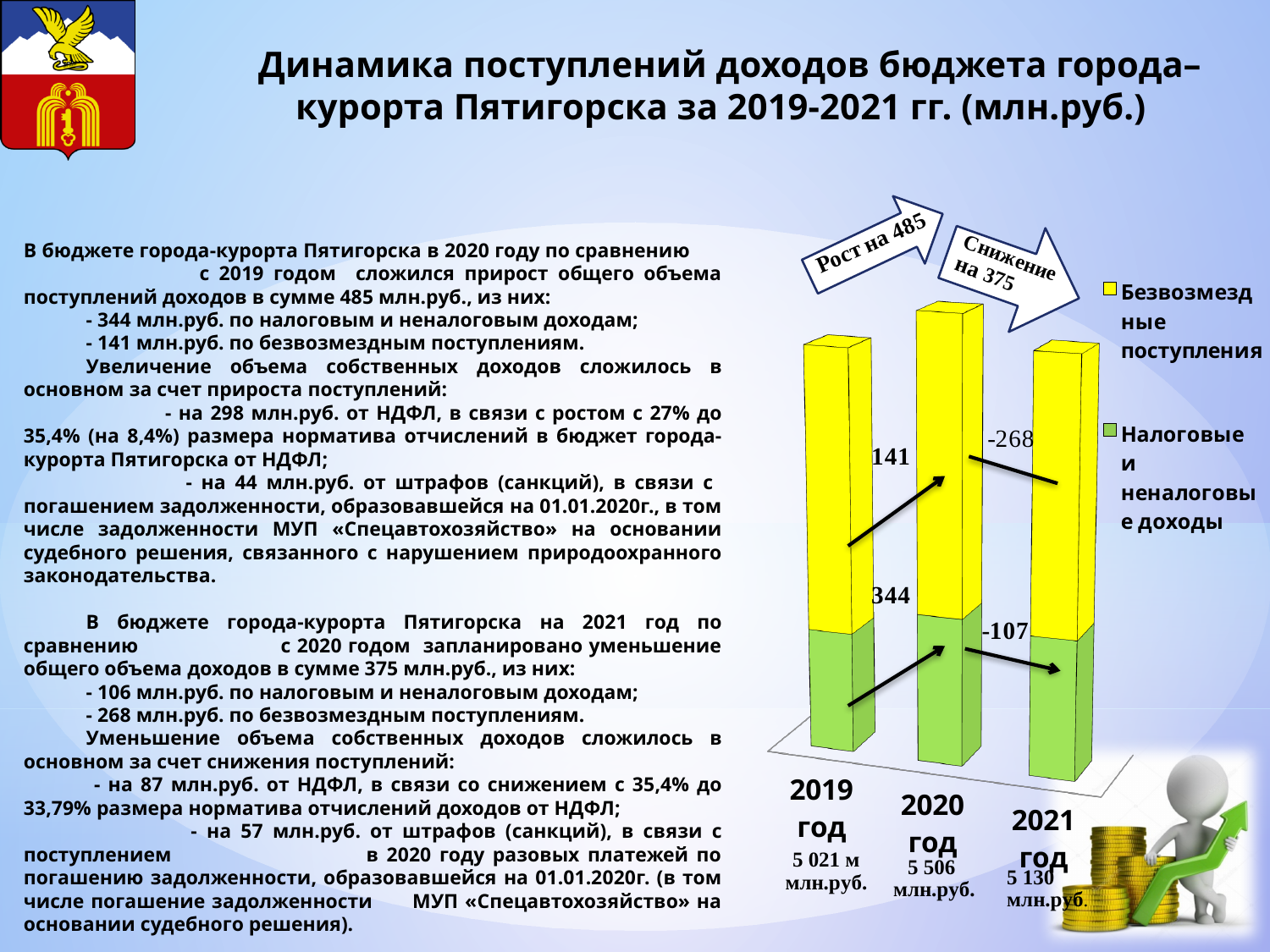
What kind of chart is shown on the slide? stacked bar chart Which colour represents 'Налоговые и неналоговые доходы' in the legend? green What is the total budget revenue shown for 2021? 5 130 млн.руб. What is the total budget revenue shown for 2020? 5 506 млн.руб. Which year has the lowest total revenue? 2019 год What change in 'Безвозмездные поступления' is labelled between 2020 and 2021? -268 How many series does the chart legend list? 2 By how much did total revenue grow from 2019 to 2020, according to the arrow label? 485 What is the total budget revenue shown for 2019? 5 021 млн.руб. Which year has the highest total revenue? 2020 год How many years (bars) does the chart show? 3 In the 2019 bar, which segment is larger: 'Безвозмездные поступления' or 'Налоговые и неналоговые доходы'? Безвозмездные поступления